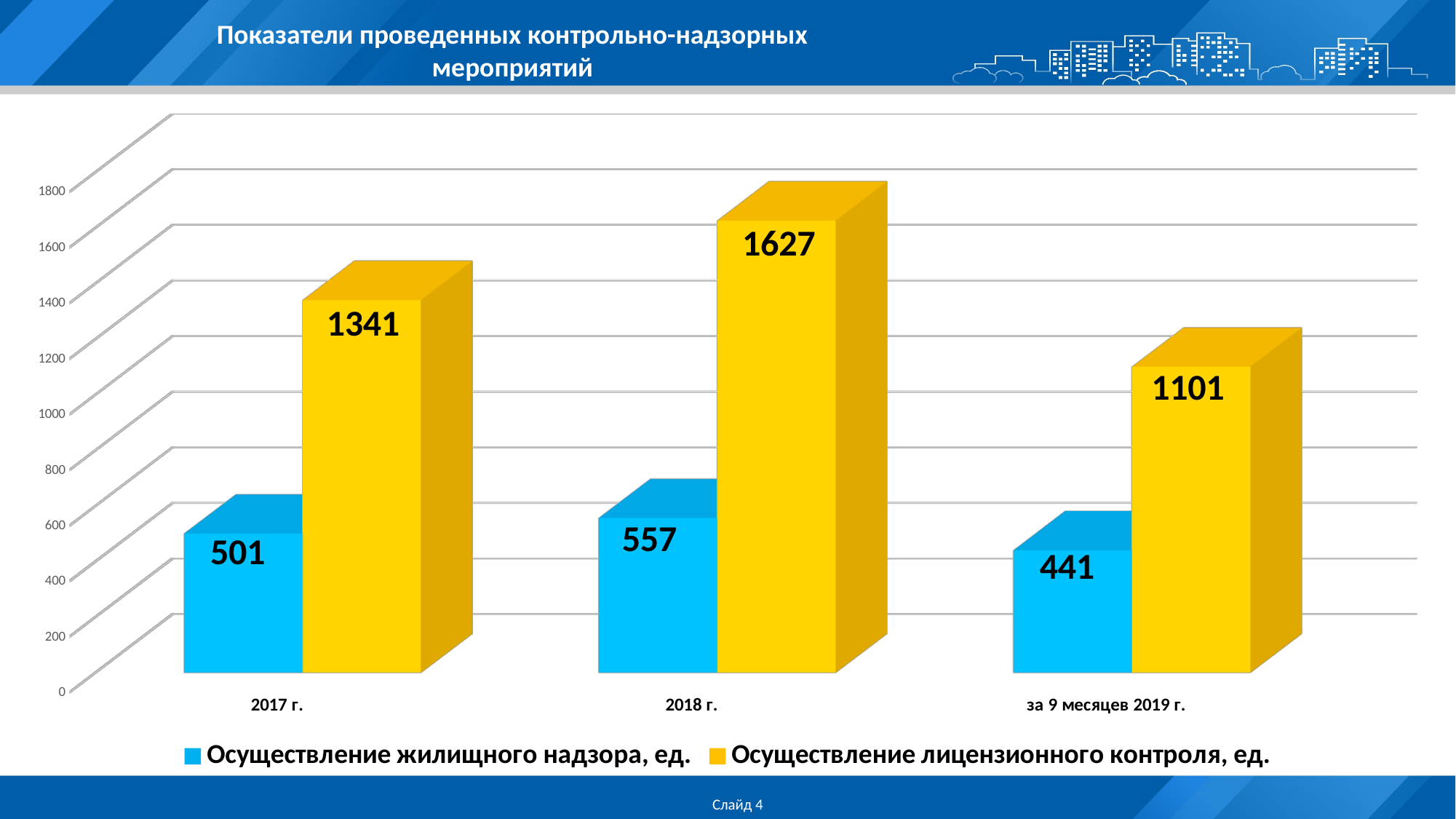
In which period is the value for "Осуществление жилищного надзора, ед." lowest? за 9 месяцев 2019 г. In which period is the value for "Осуществление лицензионного контроля, ед." highest? 2018 г. What is the difference between the "Осуществление лицензионного контроля, ед." values for 2018 г. and 2017 г.? 286 What is the difference between the "Осуществление жилищного надзора, ед." values for 2018 г. and 2017 г.? 56 How many periods are shown on the x axis? 3 Which is larger in 2017 г.: "Осуществление жилищного надзора, ед." or "Осуществление лицензионного контроля, ед."? Осуществление лицензионного контроля, ед. What is the value for "Осуществление жилищного надзора, ед." for "за 9 месяцев 2019 г."? 441 What is the value for "Осуществление лицензионного контроля, ед." for "за 9 месяцев 2019 г."? 1101 What is the value for "Осуществление жилищного надзора, ед." in 2017 г.? 501 What is the value for "Осуществление лицензионного контроля, ед." in 2018 г.? 1627 What kind of chart is shown on the slide? Bar chart How many series does the legend list? 2